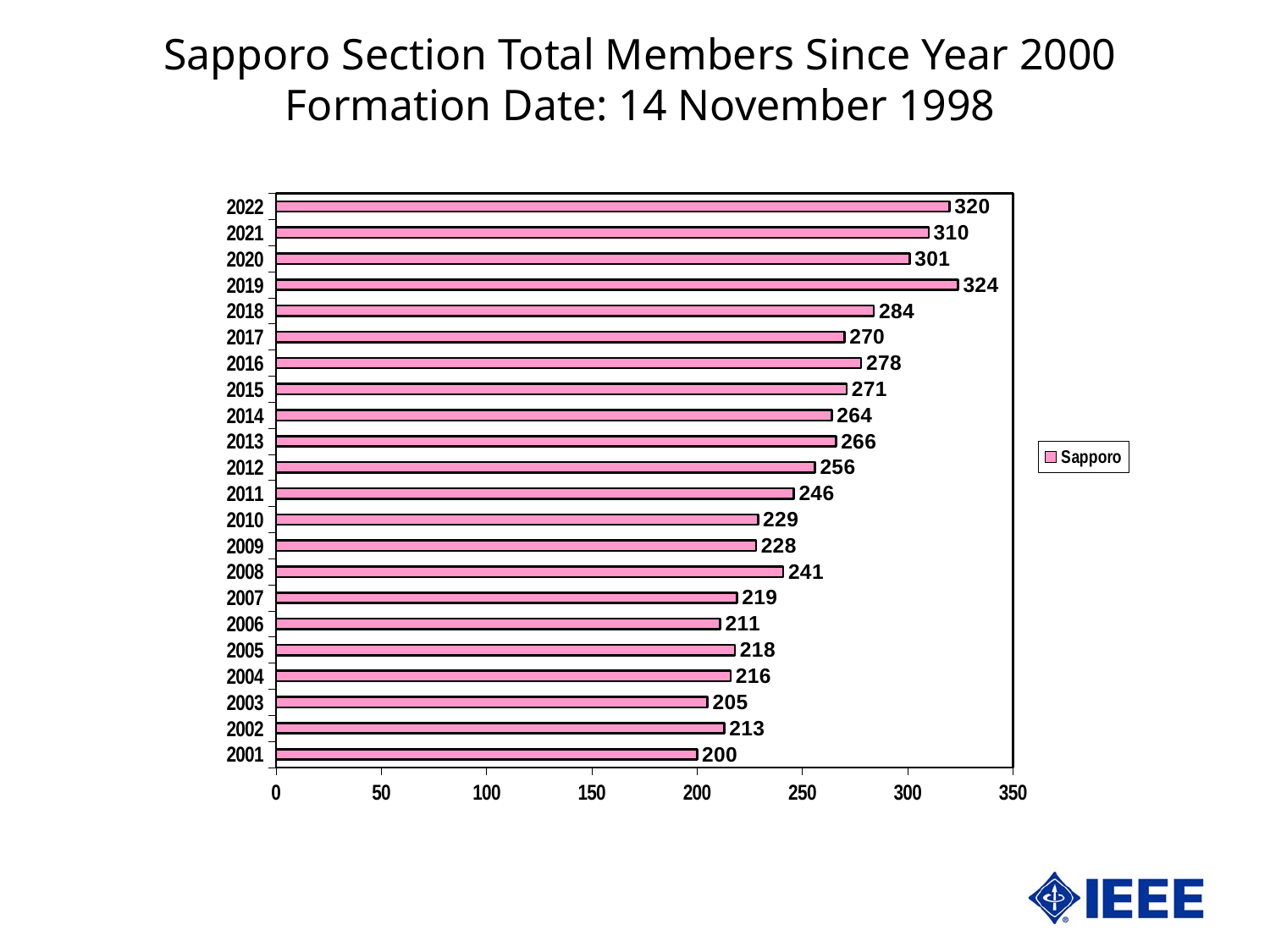
What is the value for 2012? 256 Which is larger, the value for 2018 or the value for 2017? 2018 What kind of chart is shown? bar chart What is the difference between the values for 2022 and 2021? 10 Which year has the highest value? 2019 How many years are shown on the chart? 22 What is the value for 2001? 200 What is the value for 2019? 324 Which year has the lowest value? 2001 What is the difference between the values for 2019 and 2001? 124 How many series does the legend list? 1 Is the value for 2020 greater or less than 300? greater